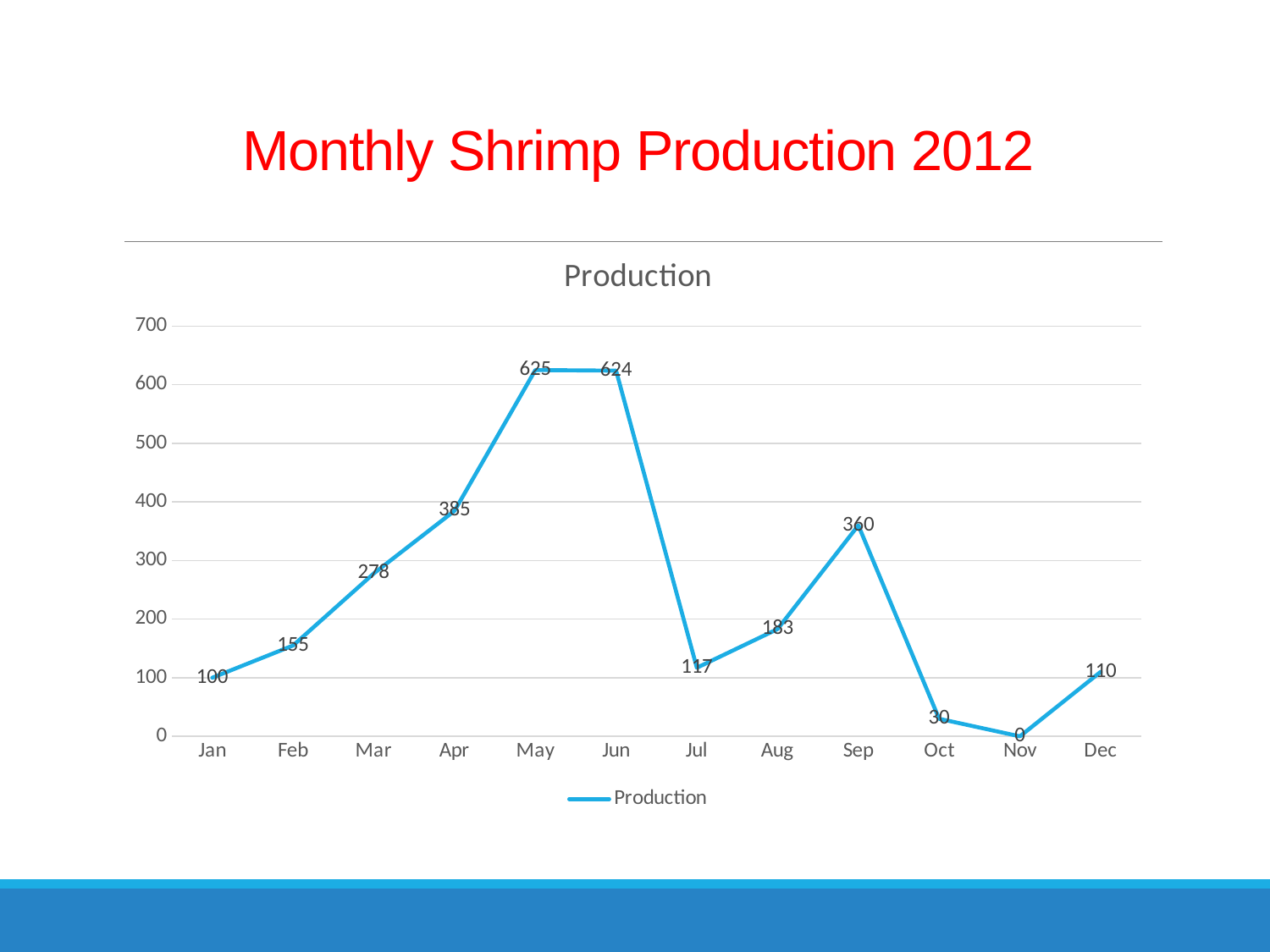
What is the production value for May? 625 What kind of chart is shown on the slide? line chart Is the production value for Mar greater or less than 300? less Which month has the lowest production? Nov Does production rise or fall from Jan to May? rise How many series does the legend list? 1 What is the production value for Nov? 0 How many months are plotted on the chart? 12 Which month has higher production, Apr or Sep? Apr Which month has the highest production? May What is the production value for Sep? 360 What is the difference between the production in Jun and the production in Jul? 507